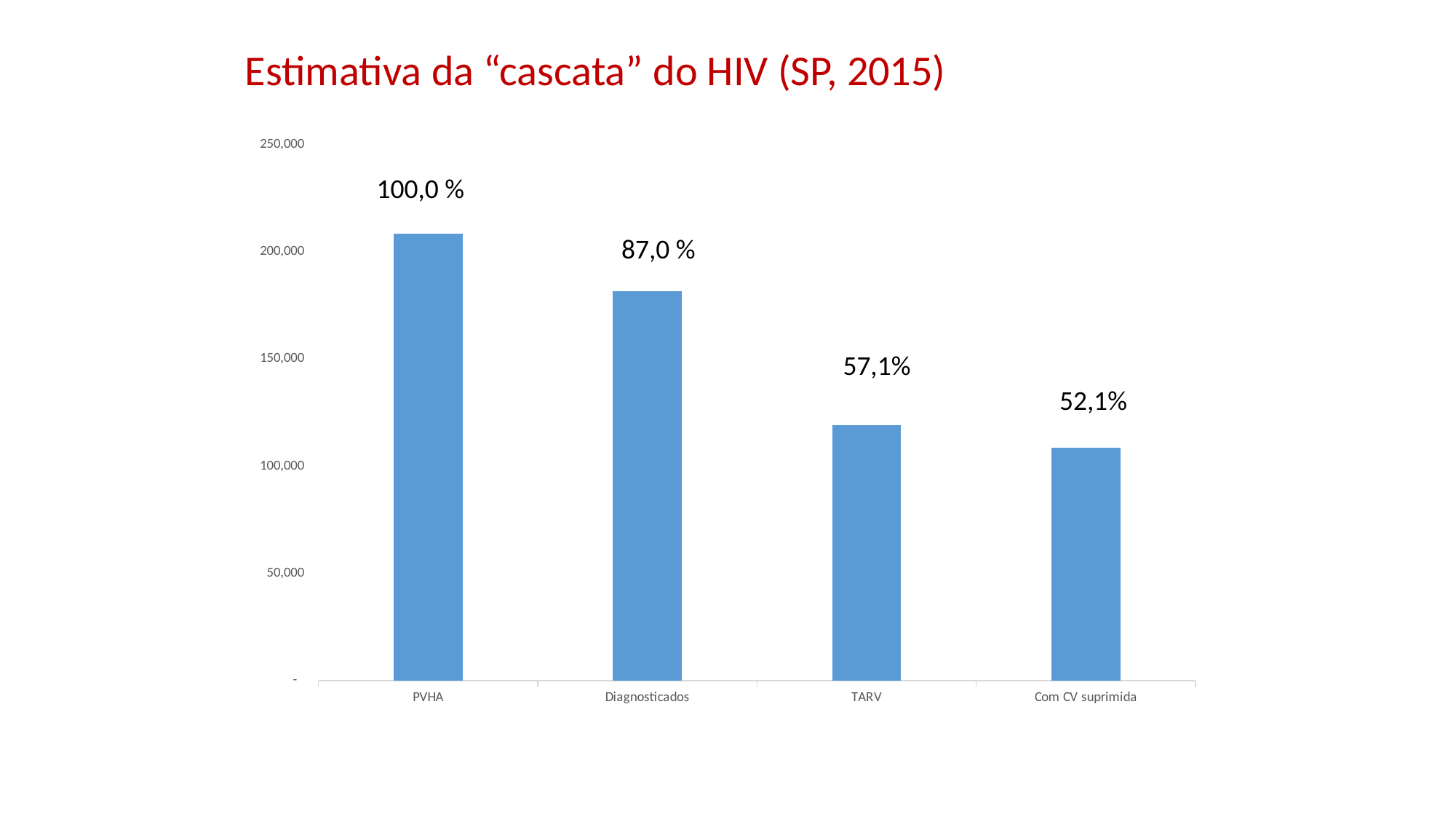
What percentage label is shown above the Diagnosticados bar? 87,0 % What percentage label is shown above the TARV bar? 57,1% Is the value for PVHA greater or less than 200,000? greater Which category has the highest bar? PVHA What percentage label is shown above the PVHA bar? 100,0 % Which category has the lowest bar? Com CV suprimida What type of chart is shown on the slide? bar chart What percentage label is shown above the Com CV suprimida bar? 52,1% What is the title of the chart? Estimativa da "cascata" do HIV (SP, 2015) Is the value for TARV greater or less than 150,000? less Do the bar values rise or fall from left to right along the x axis? fall How many categories are shown on the x axis? 4